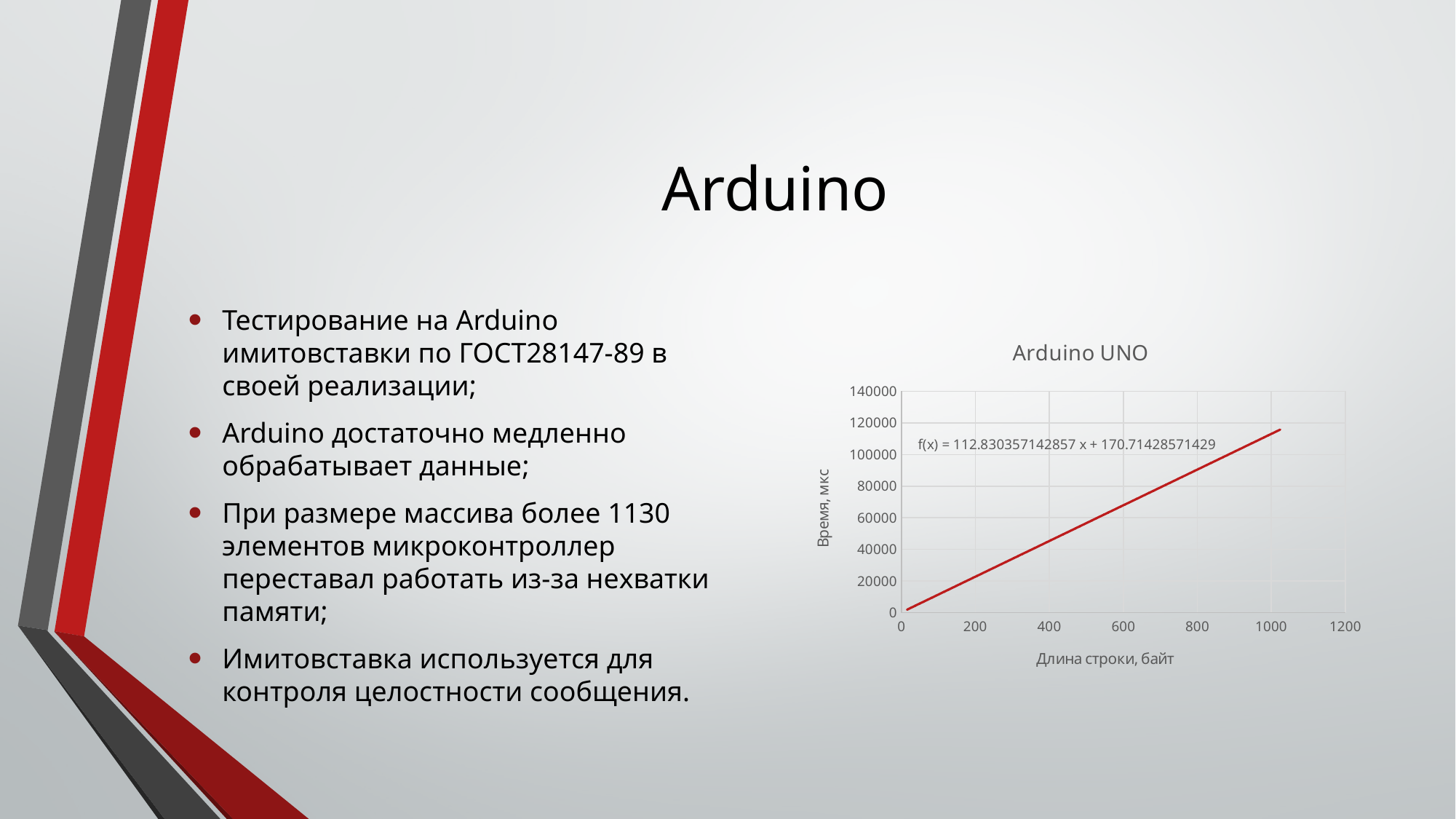
Do the values on the chart rise or fall as the string length increases along the x axis? rise What kind of chart is shown on the slide? line chart Is the value for a string length of 600 bytes greater or less than 80000? less Is the value for a string length of 800 bytes greater or less than 80000? greater Is the value for a string length of 1000 bytes greater or less than 100000? greater What is the trendline equation printed on the chart? f(x) = 112.830357142857 x + 170.71428571429 What is the title of the chart? Arduino UNO What is the highest tick value shown on the y axis of the chart? 140000 Is the value at a string length of 1000 bytes larger or smaller than the value at 200 bytes? larger What is the label of the x axis of the chart? Длина строки, байт